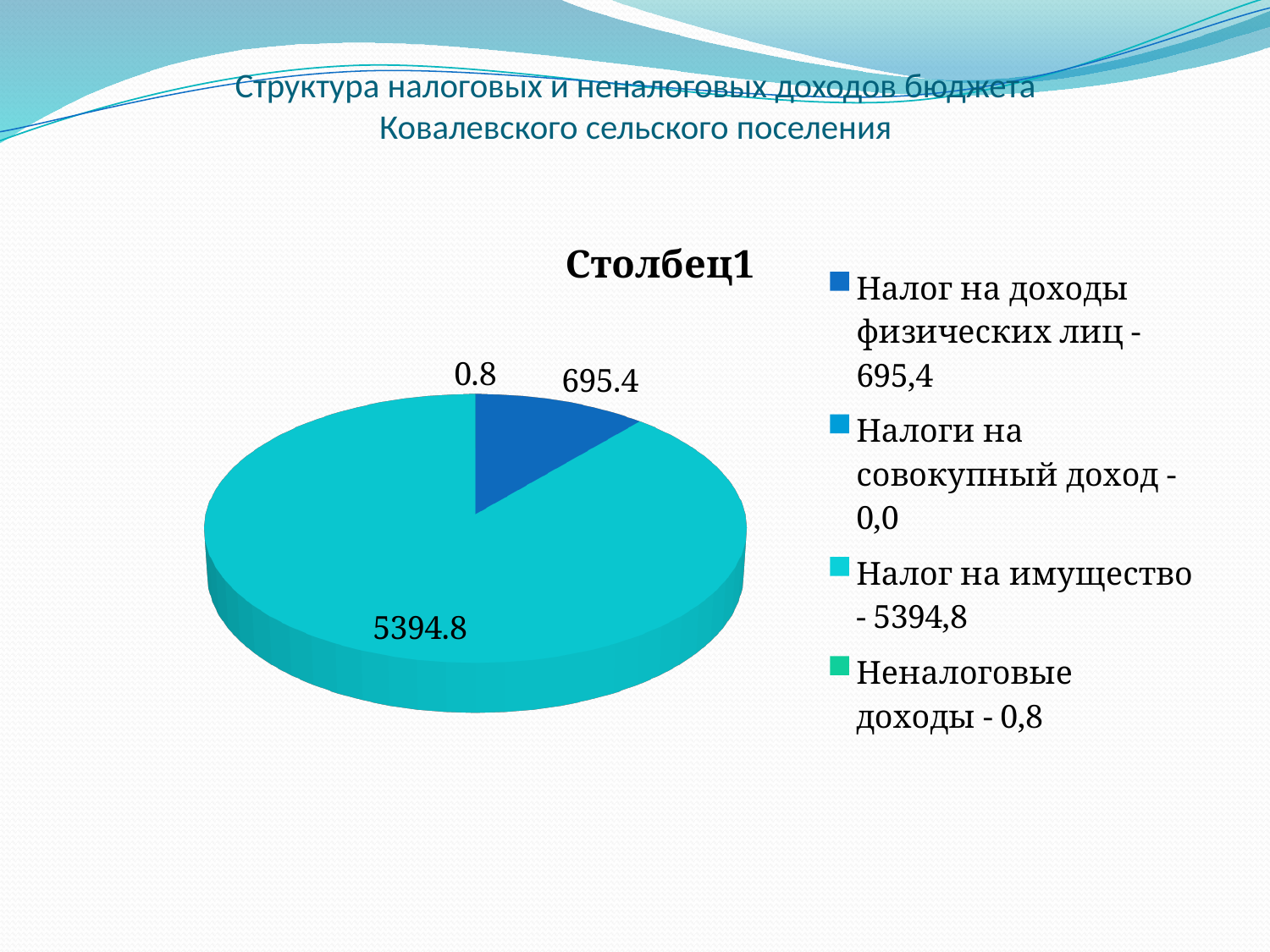
How many categories does the chart legend list? 4 What colour is the slice for Налог на доходы физических лиц? dark blue What is the difference between the values for Налог на имущество and Налог на доходы физических лиц? 4699.4 What is the value shown for Налог на доходы физических лиц? 695.4 Which is larger, Налог на доходы физических лиц or Неналоговые доходы? Налог на доходы физических лиц What is the value shown for Налог на имущество? 5394.8 What kind of chart is shown on the slide? pie chart Which category has the largest slice of the pie? Налог на имущество What is the title of the chart? Столбец1 Which category with a visible slice has the smallest value? Неналоговые доходы What value does the legend give for Налоги на совокупный доход? 0,0 What is the value shown for Неналоговые доходы? 0.8